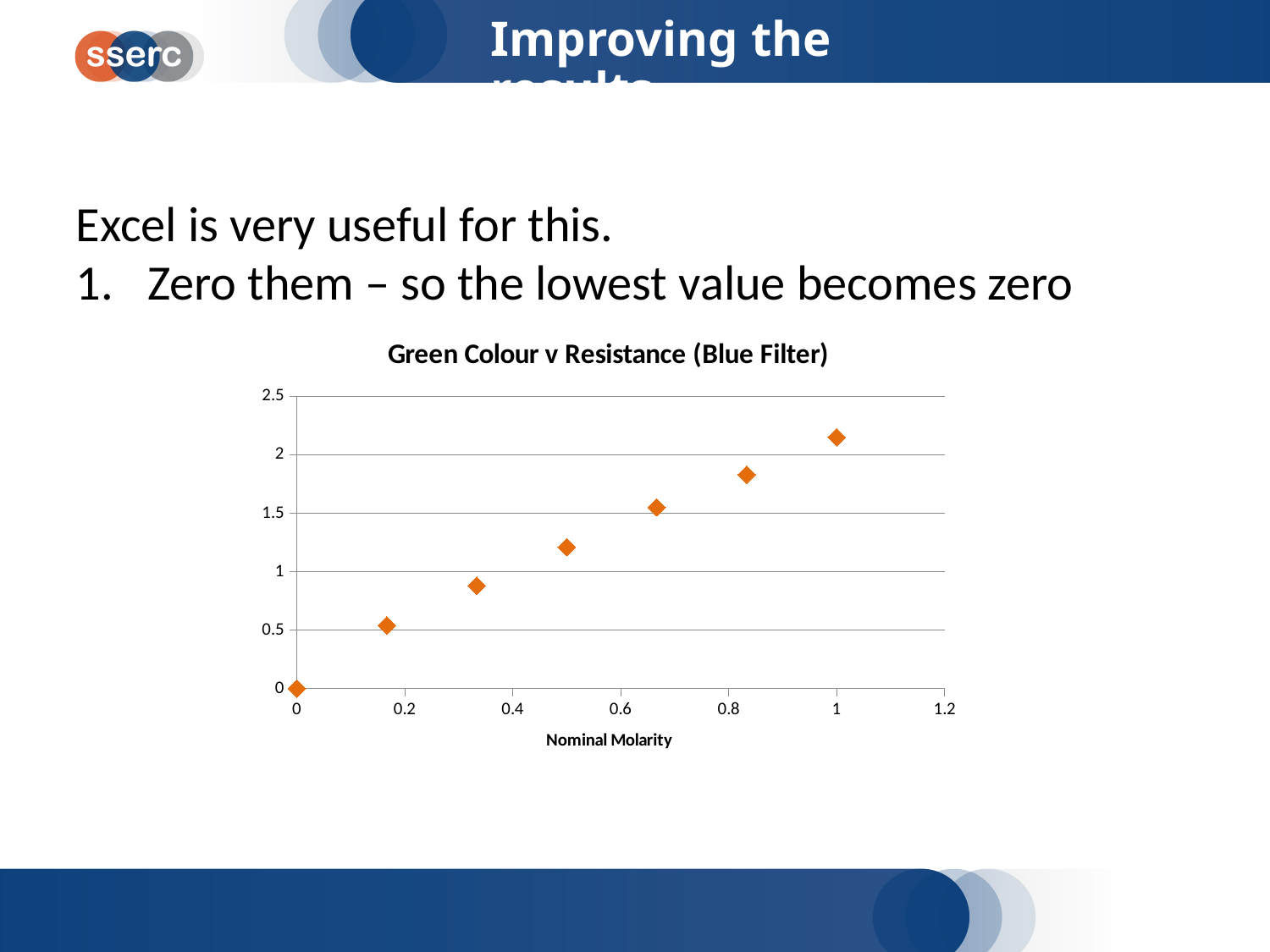
What is the title of the chart? Green Colour v Resistance (Blue Filter) Is the plotted value at a Nominal Molarity of 1 greater or less than 2? greater What is the plotted value at a Nominal Molarity of 0? 0 What type of chart is shown on the slide? scatter chart What is the label on the x axis of the chart? Nominal Molarity At which Nominal Molarity is the plotted value lowest? 0 At which Nominal Molarity is the plotted value highest? 1 Which is larger: the plotted value at a Nominal Molarity of 0.5 or at a Nominal Molarity of 1? 1 How many data points are plotted on the chart? 7 Do the plotted values rise or fall as Nominal Molarity increases? rise Is the plotted value at a Nominal Molarity of 0.5 greater or less than 1? greater